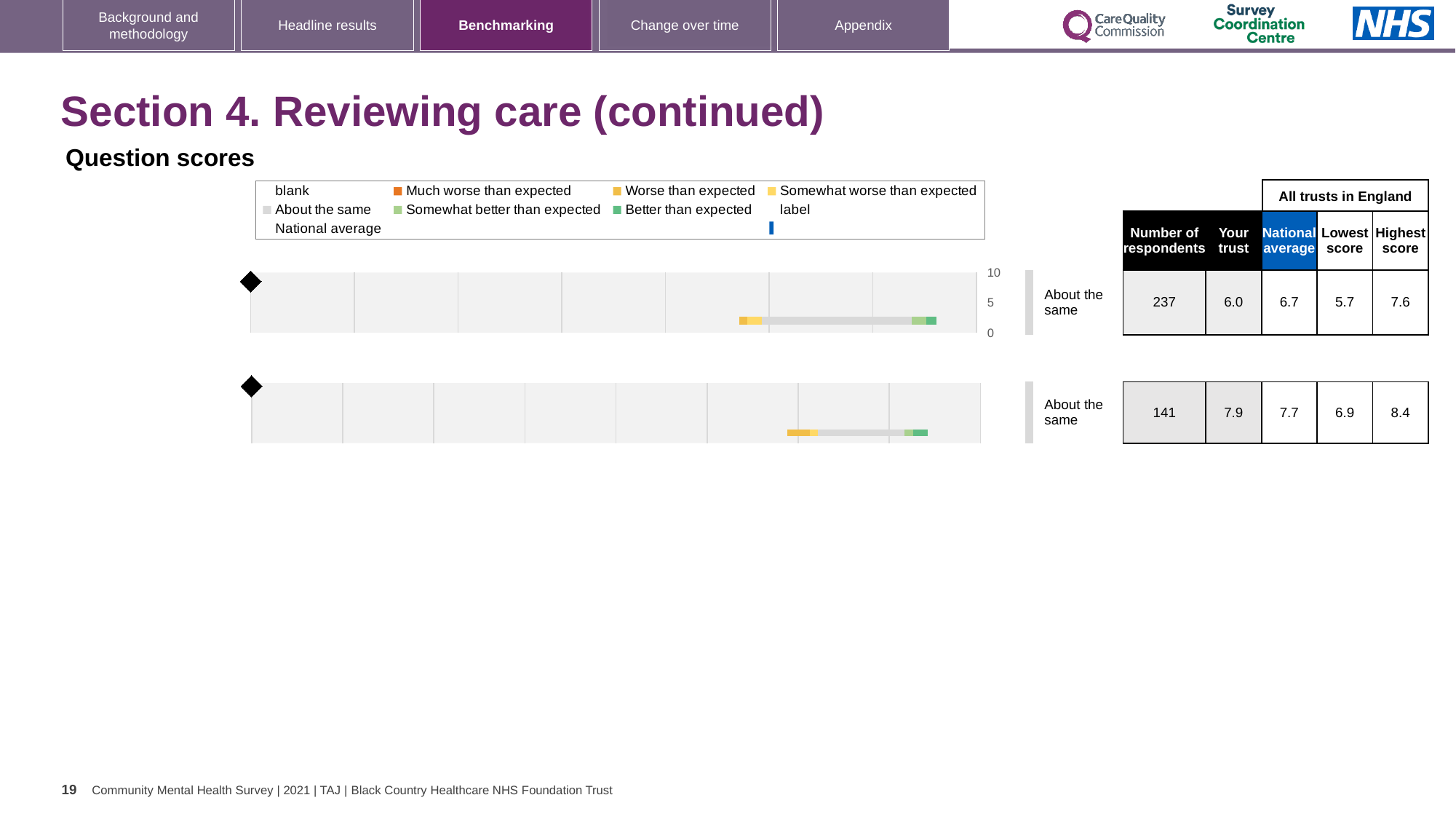
For the top chart, which is larger: the 'Your trust' score or the national average? National average What is the highest value shown on the vertical axis of the top chart? 10 For the top chart, what is the national average score shown in the table? 6.7 For the bottom chart, which is larger: the 'Your trust' score or the national average? Your trust For the bottom chart, what is the highest score among all trusts in England? 8.4 For the top chart, what is the 'Your trust' score shown in the table? 6.0 What kind of chart is used to show the question scores on this slide? bar chart For the bottom chart, what is the difference between the highest score and the lowest score among all trusts in England? 1.5 For the bottom chart, how many respondents are shown in the table? 141 How many question score charts are shown on the slide? 2 In the legend, what colour represents 'Much worse than expected'? Orange For the top chart, what is the difference between the highest score and the lowest score among all trusts in England? 1.9